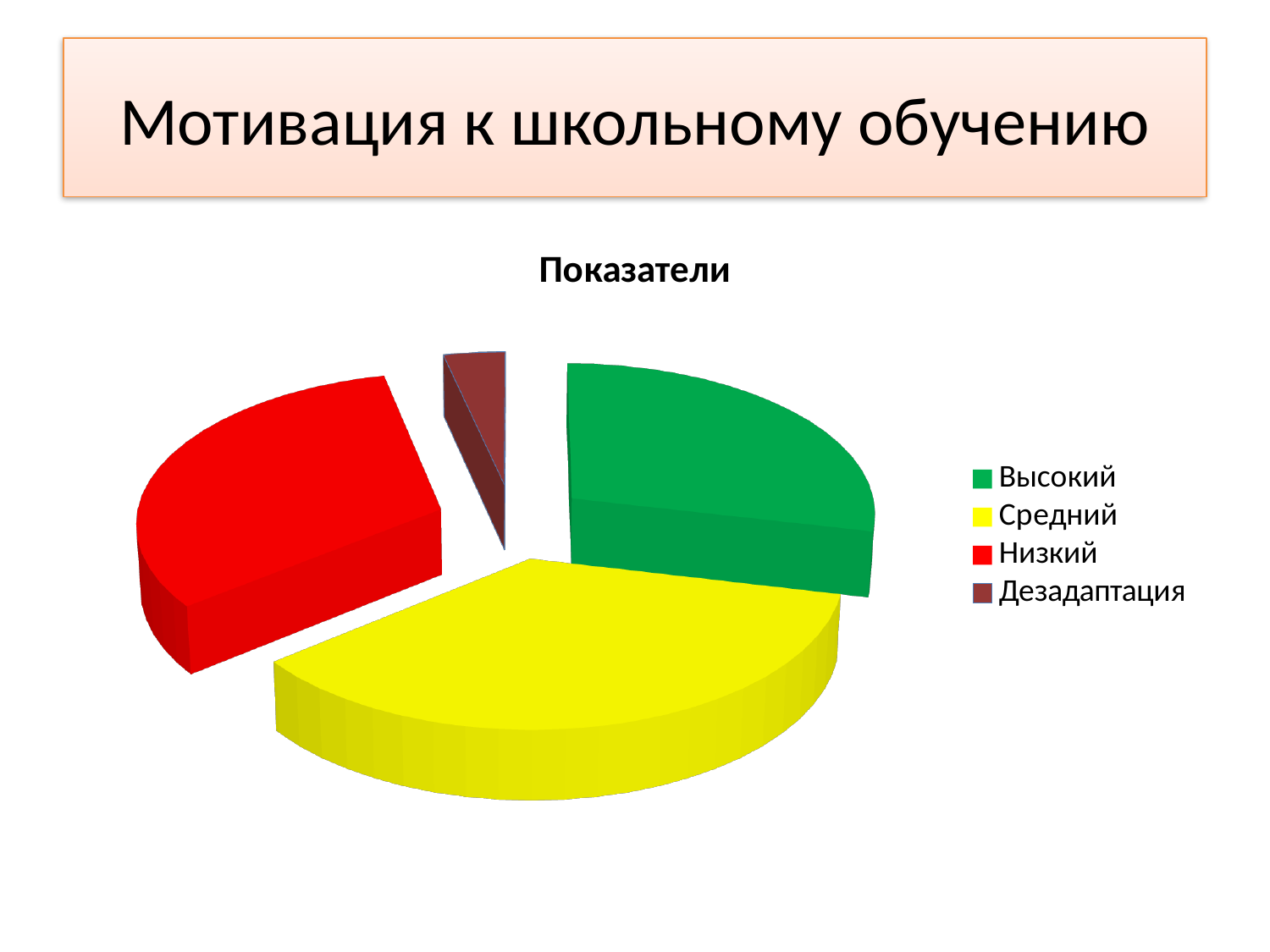
Which slice is larger, Низкий or Дезадаптация? Низкий How many entries does the legend list? 4 Which slice is larger, Средний or Высокий? Средний What is the title of the chart? Показатели How many slices does the pie chart have? 4 What colour is the slice for Низкий? red Which category has the smallest slice of the pie? Дезадаптация Which category has the largest slice of the pie? Средний Which slice is larger, Высокий or Дезадаптация? Высокий What kind of chart is shown on the slide? pie chart